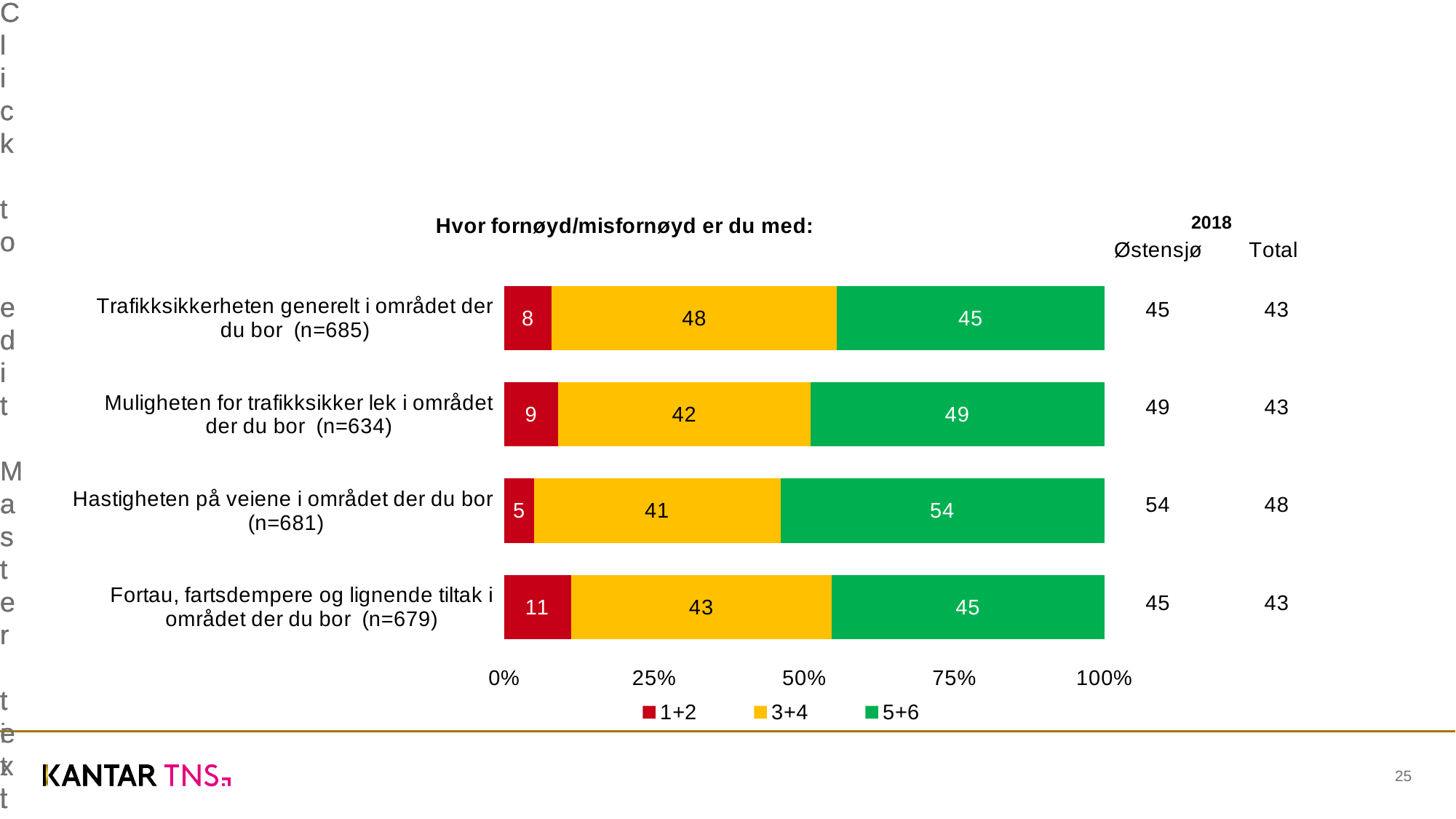
What is the 3+4 value for "Trafikksikkerheten generelt i området der du bor"? 48 How many series does the legend list? 3 Which category has the lowest 1+2 value? Hastigheten på veiene i området der du bor Which category has the highest 5+6 value? Hastigheten på veiene i området der du bor What is the 5+6 value for "Hastigheten på veiene i området der du bor"? 54 How many categories (questions) are plotted in the chart? 4 Which is larger: the 3+4 value for "Muligheten for trafikksikker lek i området der du bor" or the 3+4 value for "Fortau, fartsdempere og lignende tiltak i området der du bor"? Fortau, fartsdempere og lignende tiltak i området der du bor What is the title of the chart? Hvor fornøyd/misfornøyd er du med: What kind of chart is shown on the slide? Stacked bar chart Which colour represents the 5+6 series in the chart? Green What is the 1+2 value for "Fortau, fartsdempere og lignende tiltak i området der du bor"? 11 What is the difference between the 5+6 values for "Muligheten for trafikksikker lek i området der du bor" and "Trafikksikkerheten generelt i området der du bor"? 4